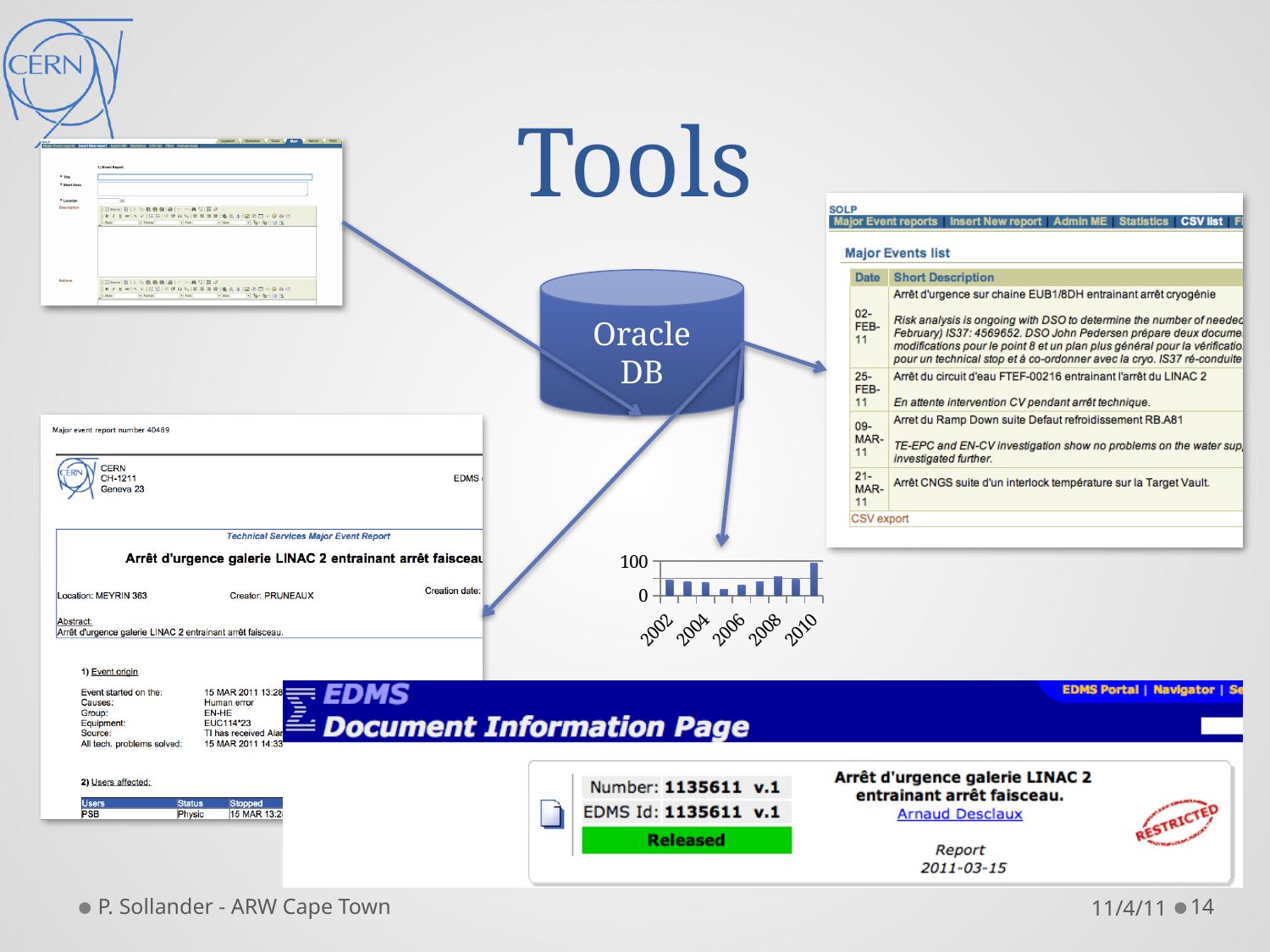
In the bar chart below the Oracle DB cylinder, is the value for 2008 greater or less than 100? less In the bar chart below the Oracle DB cylinder, is the value for 2004 greater or less than 100? less In the bar chart below the Oracle DB cylinder, is the value for 2002 greater or less than 100? less What is the highest value labelled on the y axis of the bar chart below the Oracle DB cylinder? 100 What is the first year label shown on the x axis of the bar chart below the Oracle DB cylinder? 2002 What kind of chart is shown below the Oracle DB cylinder? bar chart